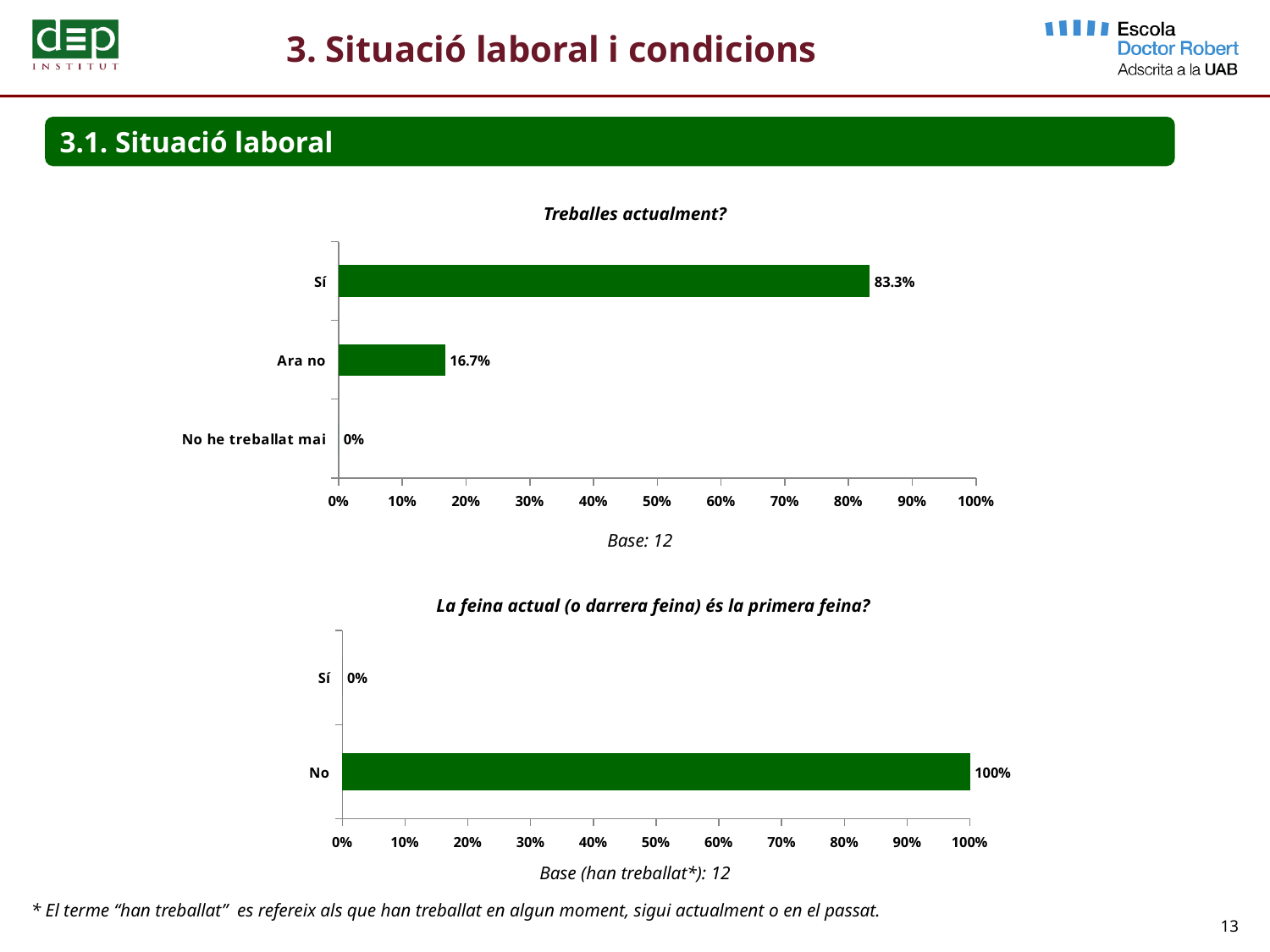
In the 'La feina actual (o darrera feina) és la primera feina?' chart, which is larger, 'Sí' or 'No'? No In the 'Treballes actualment?' chart, what is the value for 'Ara no'? 16.7% In the 'Treballes actualment?' chart, what is the difference between the values for 'Sí' and 'Ara no'? 66.6% In the 'Treballes actualment?' chart, how many categories are shown? 3 In the 'Treballes actualment?' chart, which category has the lowest value? No he treballat mai What kind of chart is the 'Treballes actualment?' chart? Bar chart In the 'Treballes actualment?' chart, is the value for 'Sí' greater or less than 80%? greater In the 'Treballes actualment?' chart, which category has the highest value? Sí In the 'Treballes actualment?' chart, what is the value for 'Sí'? 83.3% In the 'Treballes actualment?' chart, what is the value for 'No he treballat mai'? 0% In the 'La feina actual (o darrera feina) és la primera feina?' chart, what is the value for 'No'? 100% In the 'La feina actual (o darrera feina) és la primera feina?' chart, what is the value for 'Sí'? 0%